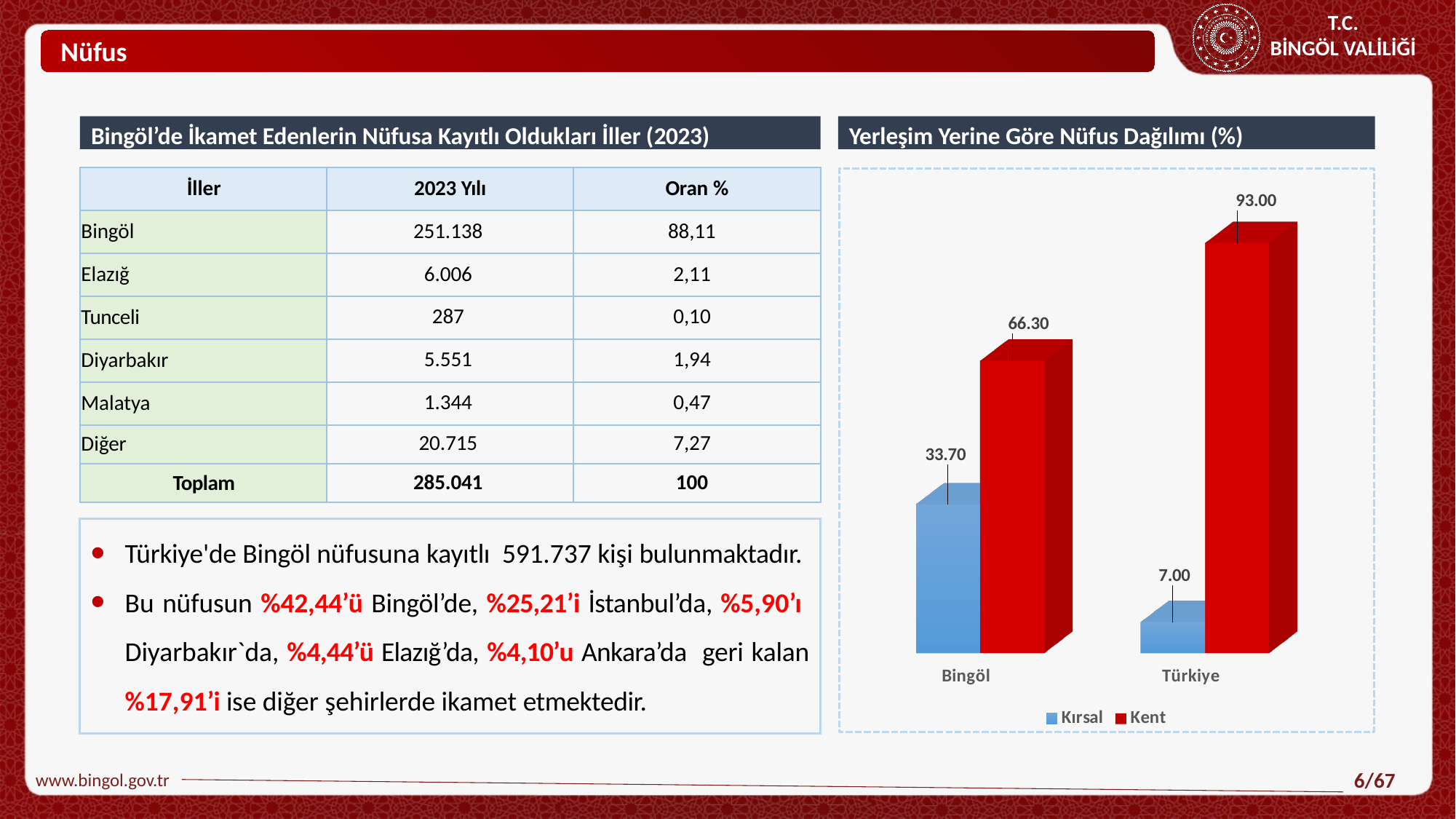
How many categories are shown on the x axis of the chart? 2 What is the difference between the Kent and Kırsal values for Bingöl? 32.60 How many series does the chart legend list? 2 What type of chart is shown on the slide? Bar chart Which bar in the chart has the lowest value? Kırsal for Türkiye Which is larger, the Kırsal value for Bingöl or the Kırsal value for Türkiye? Bingöl Which bar in the chart has the highest value? Kent for Türkiye What is the Kent value for Türkiye in the chart? 93.00 What is the Kırsal value for Türkiye in the chart? 7.00 What is the Kırsal value for Bingöl in the chart? 33.70 What is the Kent value for Bingöl in the chart? 66.30 What is the difference between the Kent values for Türkiye and Bingöl? 26.70